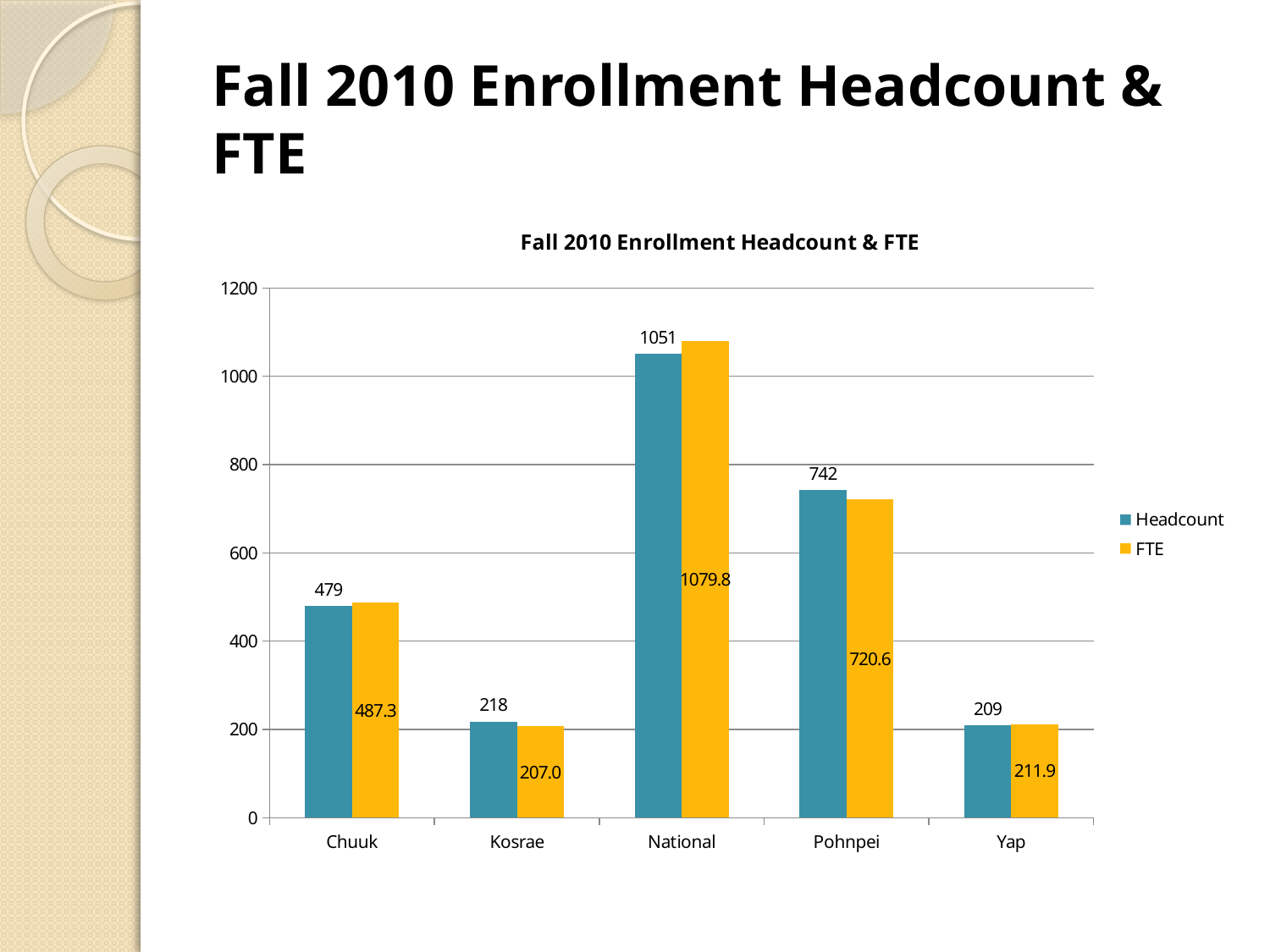
Which is larger for Yap, the Headcount or the FTE? FTE Is the FTE value for National greater or less than 1000? greater Which campus has the highest Headcount? National What is the FTE value for Kosrae? 207.0 What is the difference between the Headcount for Pohnpei and the Headcount for Chuuk? 263 What is the FTE value for Pohnpei? 720.6 What colour are the FTE bars? yellow/orange What kind of chart is shown on the slide? bar chart How many campuses are shown on the x axis? 5 How many series does the legend list? 2 What is the Headcount value for National? 1051 Which campus has the lowest FTE? Kosrae